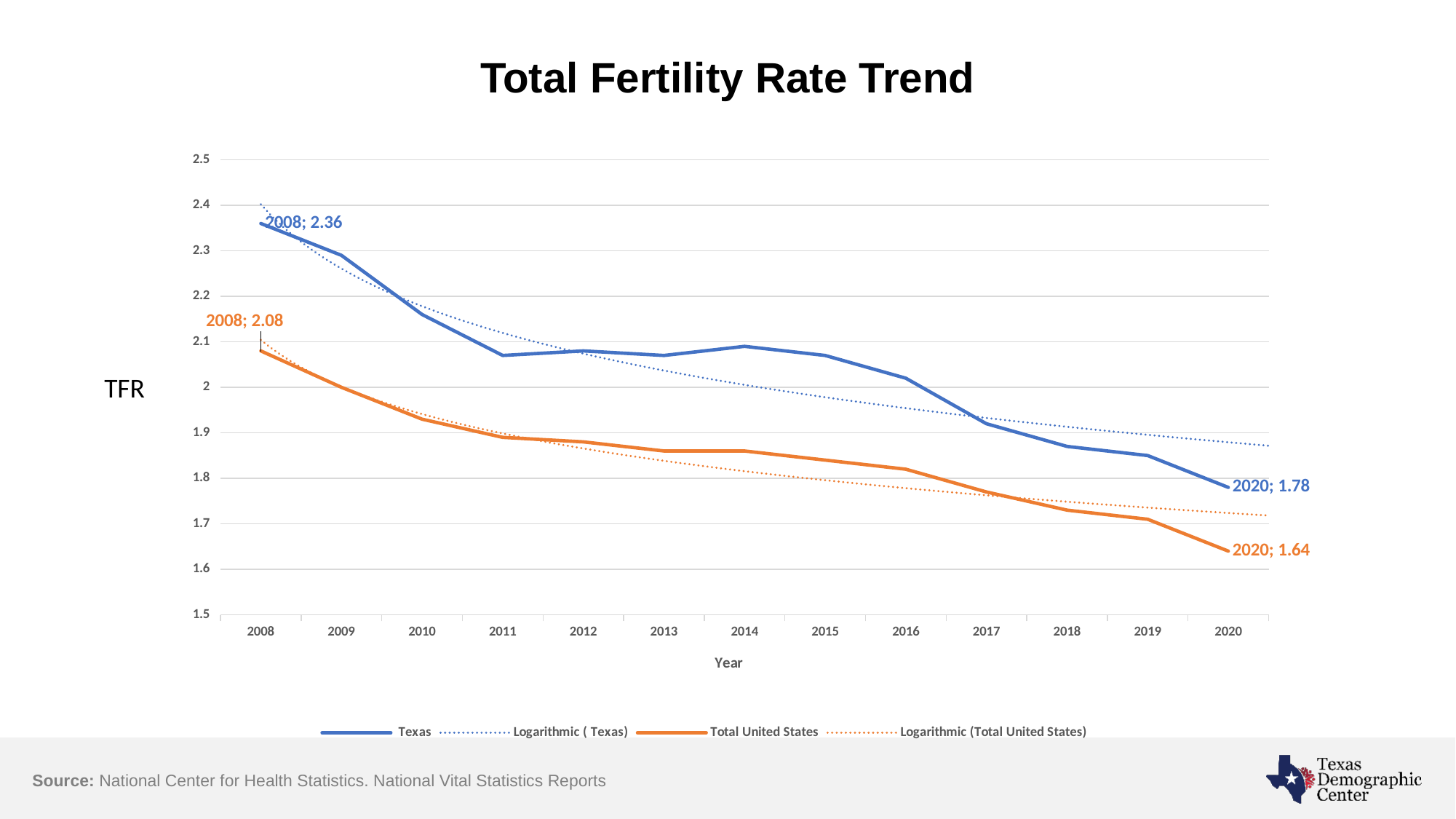
Is the Texas value for 2014 greater or less than 2.0? greater What is the Texas total fertility rate in 2020? 1.78 By how much did the Texas total fertility rate fall from 2008 to 2020? 0.58 What is the Total United States total fertility rate in 2008? 2.08 What is the difference between the Texas and Total United States fertility rates in 2020? 0.14 How many series does the legend list? 4 What is the Texas total fertility rate in 2008? 2.36 Is the Total United States value for 2016 greater or less than 1.9? less Which series has the higher value in 2008, Texas or Total United States? Texas What is the Total United States total fertility rate in 2020? 1.64 How many years are shown on the x axis? 13 What kind of chart is shown on the slide? Line chart